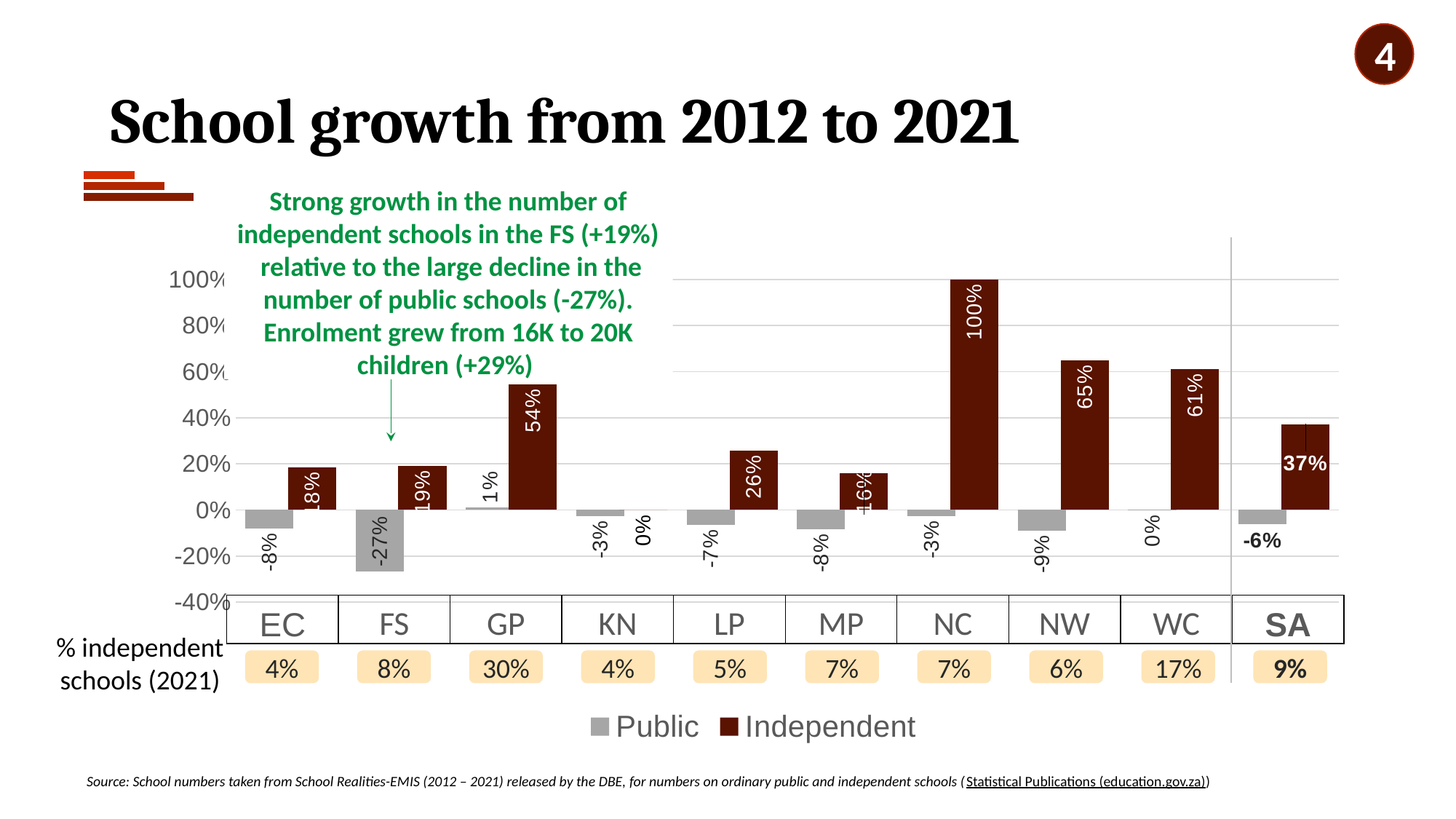
What is the difference between the Independent growth for NW (65%) and WC (61%)? 4 percentage points What is the Independent school growth value for SA? 37% How many provinces/categories are shown along the x axis? 10 Which is larger, the Independent growth for GP or for NW? NW Which category has the highest Independent school growth? NC How many series does the legend list? 2 What is the Independent school growth value for NC? 100% What kind of chart is shown on the slide? bar chart What is the Public school growth value for FS? -27% What are the two series named in the legend? Public and Independent Which category has the lowest Public school growth? FS What is the Public school growth value for WC? 0%